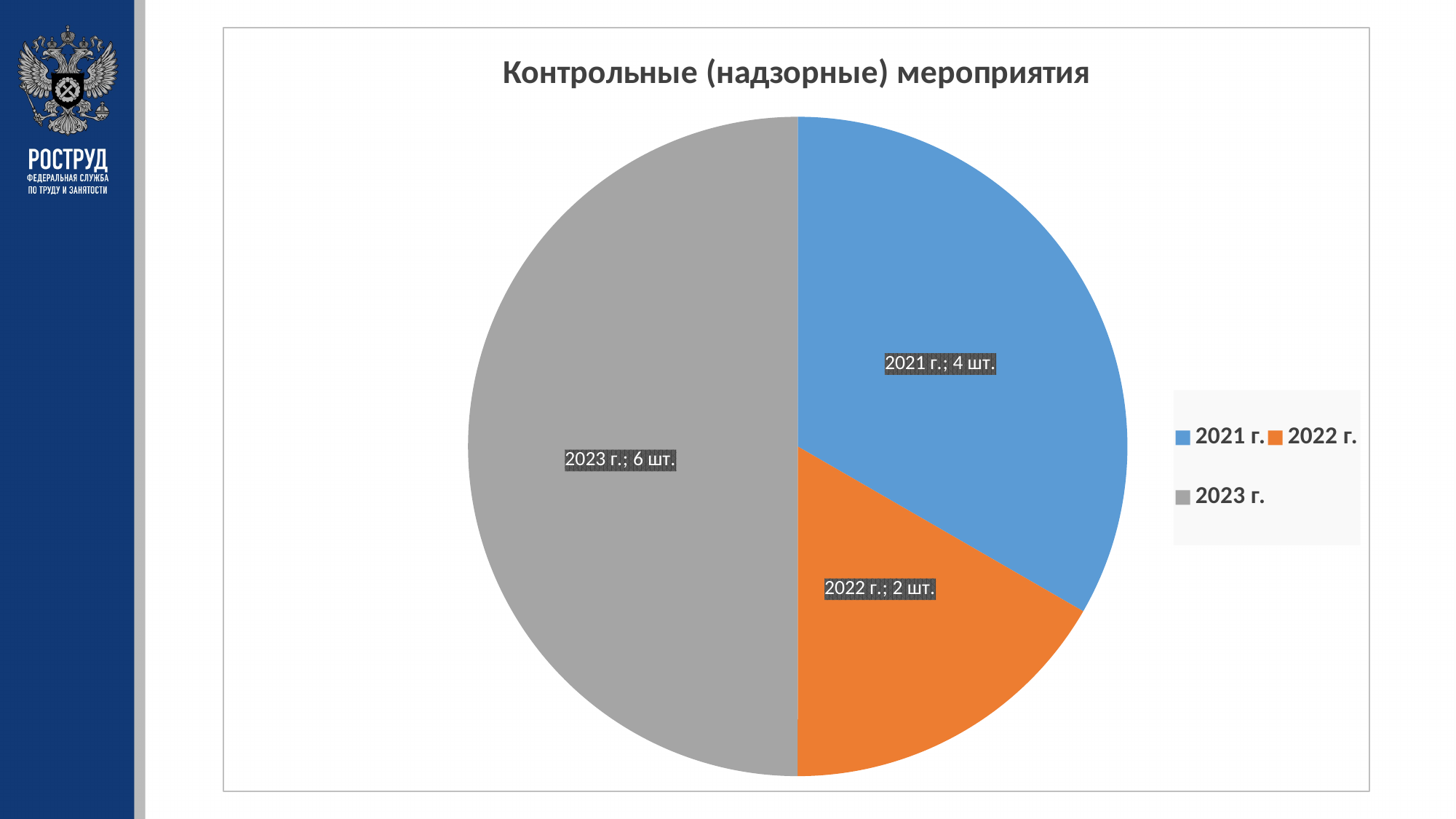
What is the value for 2023 г.? 6 шт. What is the title of the chart? Контрольные (надзорные) мероприятия Which year has the smallest slice? 2022 г. What colour is the slice for 2022 г.? orange How many slices does the pie chart have? 3 What is the difference between the values for 2023 г. and 2021 г.? 2 шт. What kind of chart is shown on the slide? pie chart What is the value for 2022 г.? 2 шт. Which is larger, the value for 2021 г. or 2022 г.? 2021 г. What share of the pie does 2023 г. represent? 50% What is the value for 2021 г.? 4 шт. Which year has the largest slice? 2023 г.